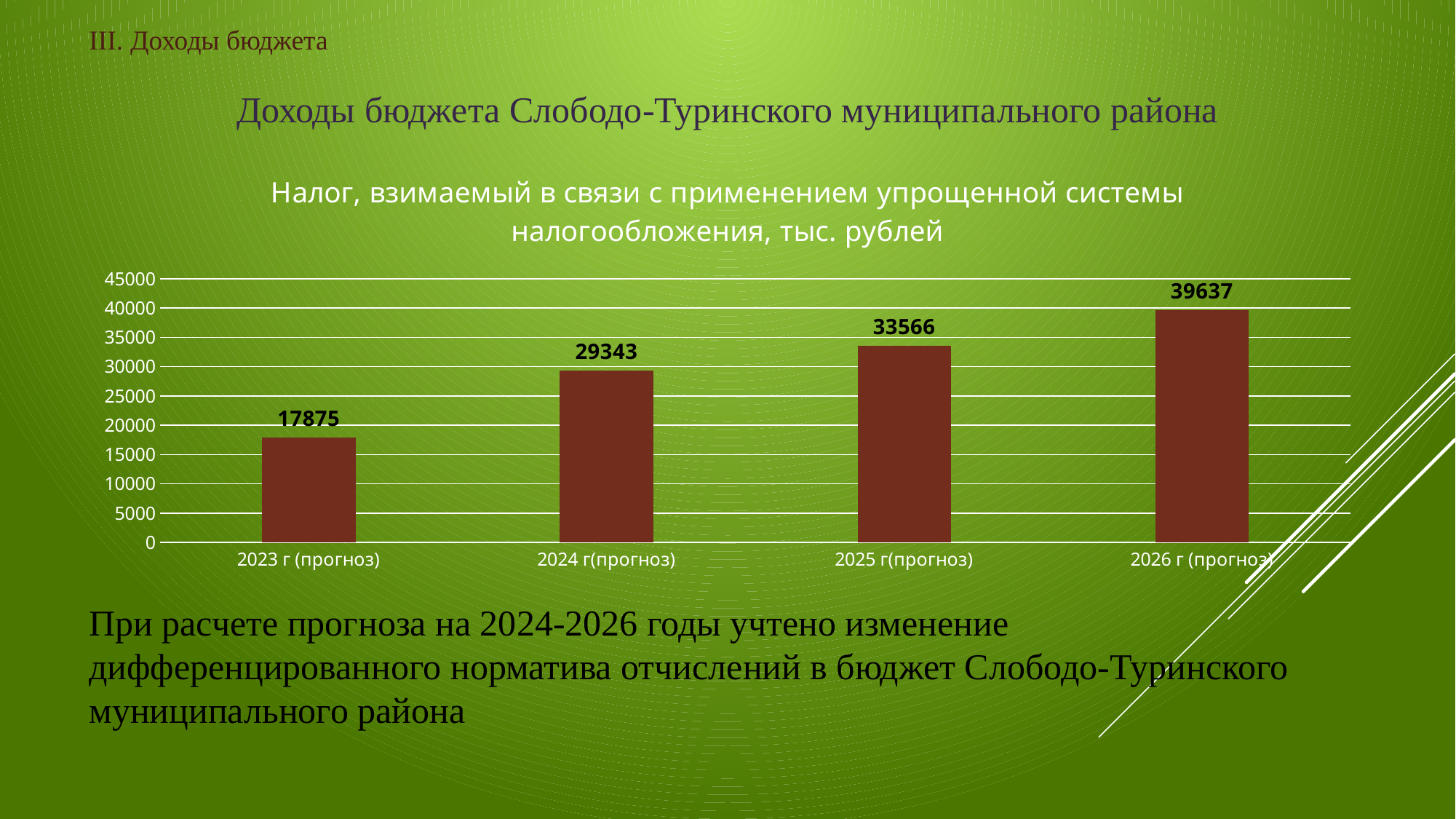
What is the value for 2025 г(прогноз)? 33566 What kind of chart is shown on the slide? bar chart What is the value for 2023 г (прогноз)? 17875 Which is larger, the value for 2024 г(прогноз) or the value for 2025 г(прогноз)? 2025 г(прогноз) Which year has the highest value? 2026 г (прогноз) What is the value for 2024 г(прогноз)? 29343 How many categories are shown on the x axis? 4 What is the value for 2026 г (прогноз)? 39637 Is the value for 2026 г (прогноз) greater or less than 35000? greater What is the difference between the values for 2026 г (прогноз) and 2023 г (прогноз)? 21762 What is the difference between the values for 2025 г(прогноз) and 2024 г(прогноз)? 4223 Which year has the lowest value? 2023 г (прогноз)